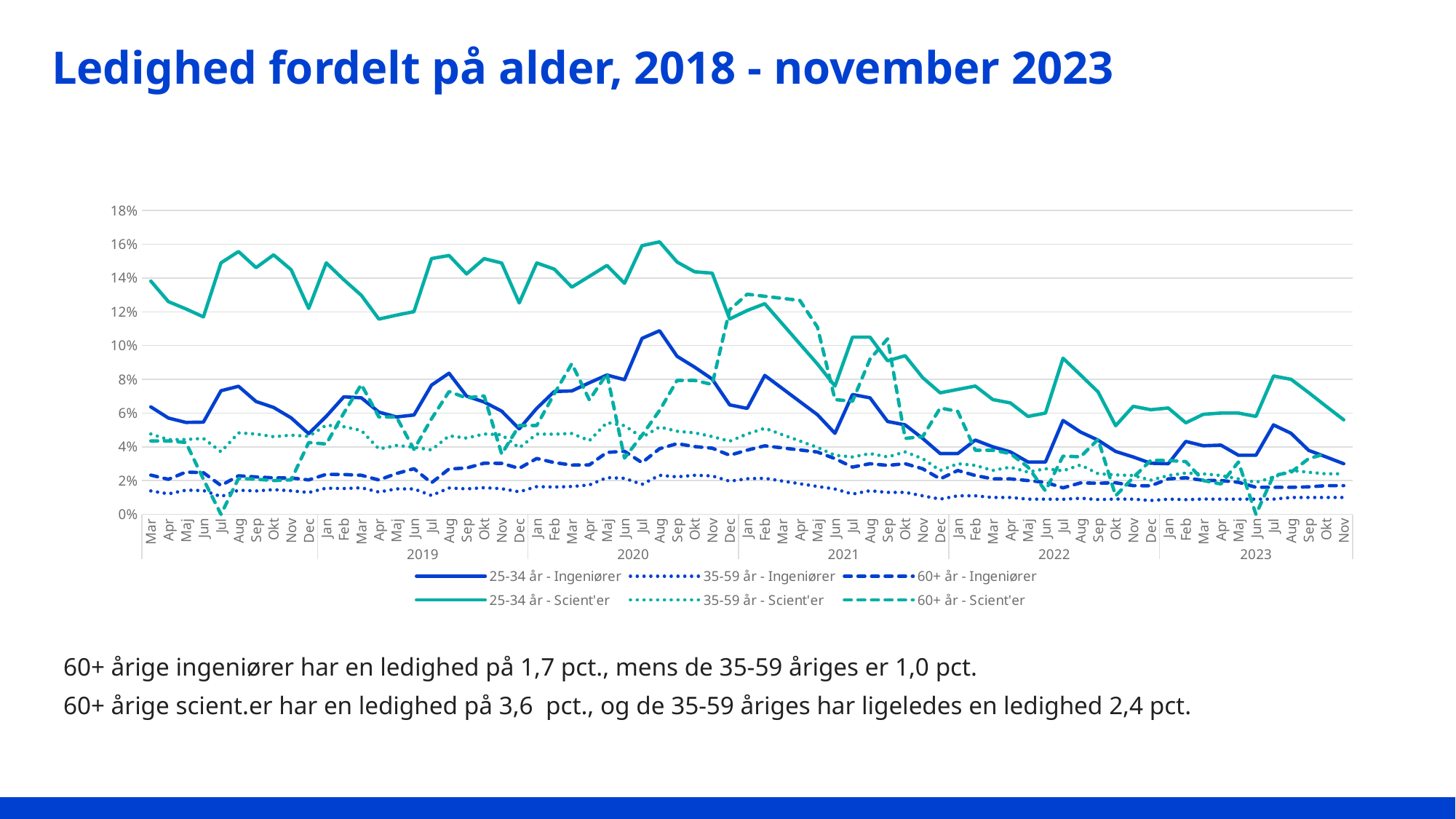
According to the text on the slide, what is the unemployment rate for 35-59 årige scient.er? 2,4 pct. According to the text on the slide, what is the unemployment rate for 60+ årige ingeniører? 1,7 pct. Is the value for 25-34 år - Ingeniører in Aug 2020 greater or less than 10%? greater What kind of chart is shown on the slide? Line chart Does the 25-34 år - Scient'er series overall rise or fall from 2018 to November 2023? Fall Using the values in the text, how much higher is the unemployment rate for 60+ årige scient.er than for 35-59 årige scient.er? 1,2 pct. How many series does the chart's legend list? 6 According to the text on the slide, what is the unemployment rate for 60+ årige scient.er? 3,6 pct. Is the value for 25-34 år - Ingeniører in Nov 2023 greater or less than 4%? less According to the text on the slide, what is the unemployment rate for 35-59 årige ingeniører? 1,0 pct. What is the title of the chart slide? Ledighed fordelt på alder, 2018 - november 2023 Which series has the highest value at the start of the chart (Mar 2018)? 25-34 år - Scient'er